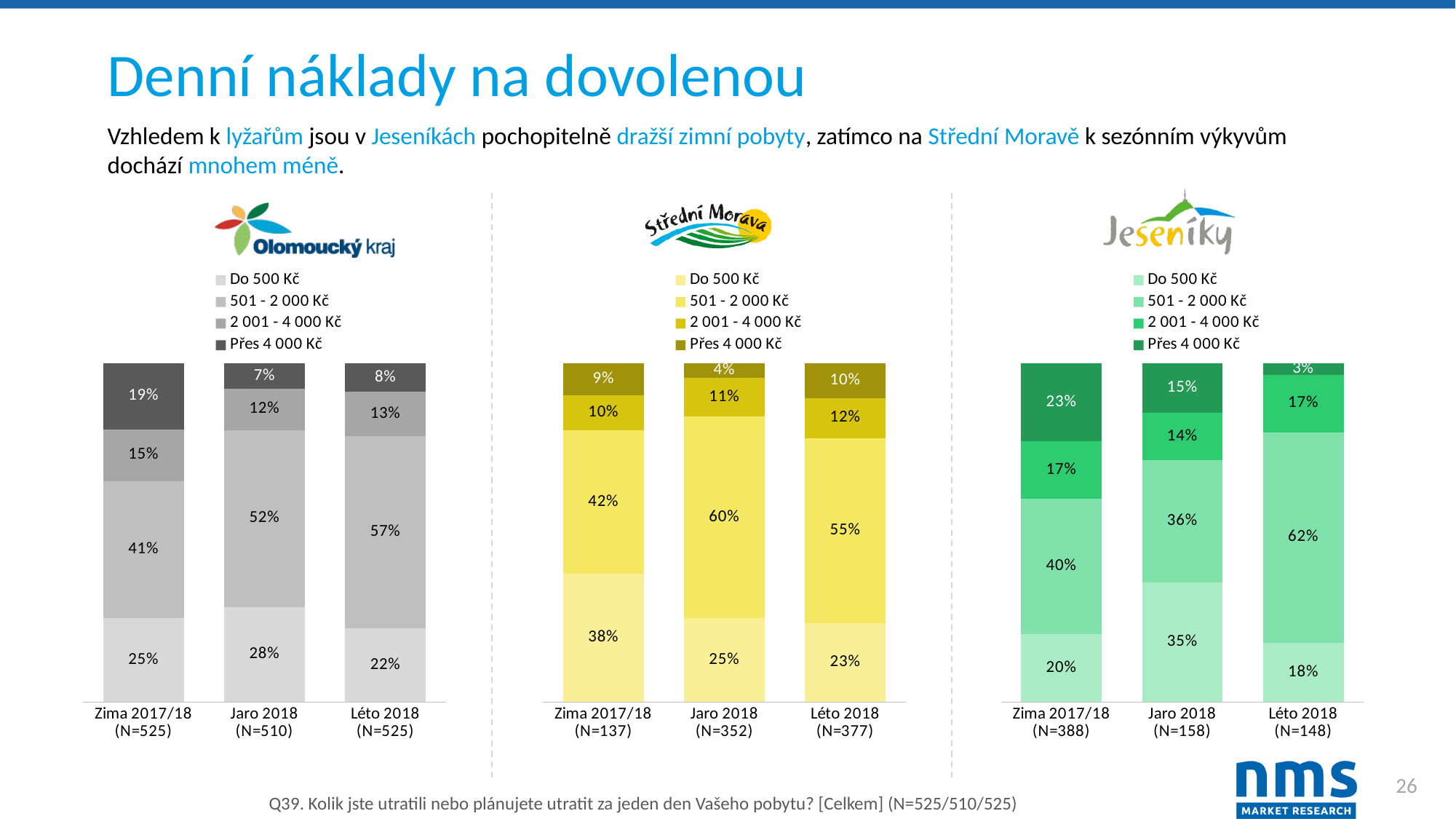
In the Jeseníky chart, which period has the highest value for '501 - 2 000 Kč'? Léto 2018 In the Střední Morava chart, which period has the lowest value for 'Přes 4 000 Kč'? Jaro 2018 How many series does the legend of the Olomoucký kraj chart list? 4 What is the sample size (N) shown for Zima 2017/18 in the Střední Morava chart? N=137 In the Jeseníky chart, what is the value for 'Přes 4 000 Kč' in Zima 2017/18? 23% How many periods (categories) are shown on the x axis of the Střední Morava chart? 3 In the Olomoucký kraj chart, what is the difference between the '501 - 2 000 Kč' values for Léto 2018 and Zima 2017/18? 16% In the Jeseníky chart, does the 'Přes 4 000 Kč' value rise or fall from Zima 2017/18 to Léto 2018? Fall In the Střední Morava chart, what is the value for '501 - 2 000 Kč' in Jaro 2018? 60% In the Jeseníky chart, is the '2 001 - 4 000 Kč' value larger in Zima 2017/18 or in Léto 2018? Neither; both are 17% In the Olomoucký kraj chart, what is the value for 'Do 500 Kč' in Jaro 2018? 28% What kind of chart is used for Jeseníky? Stacked bar chart